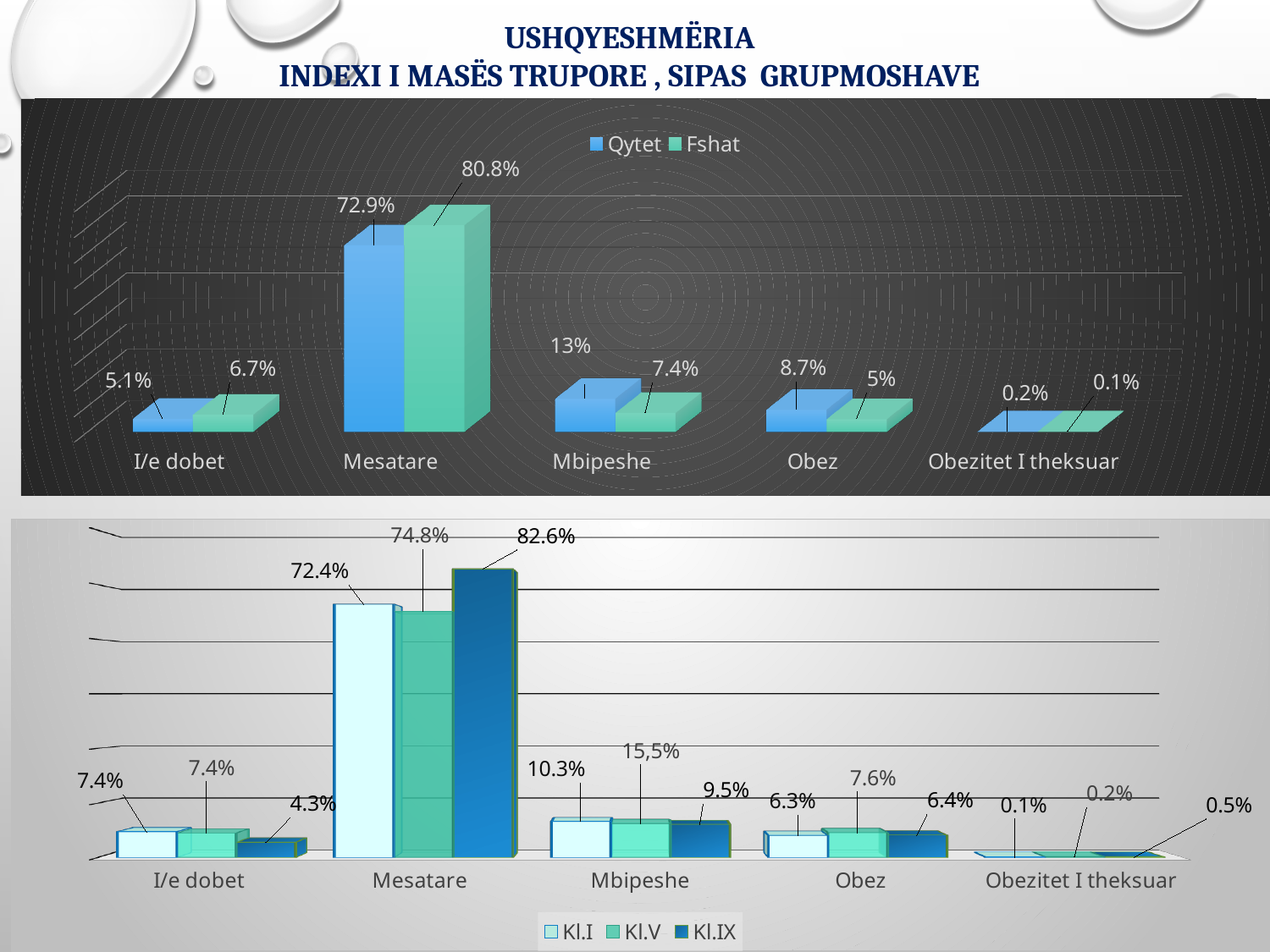
In the top chart, which category has the highest Fshat value? Mesatare In the top chart, what is the Qytet value for Mesatare? 72.9% In the top chart, what is the difference between the Fshat and Qytet values for Mesatare? 7.9% In the bottom chart, what is the Kl.IX value for Mesatare? 82.6% In the top chart, what is the Fshat value for Mbipeshe? 7.4% In the top chart, how many series does the legend list? 2 In the top chart, which category has the lowest Qytet value? Obezitet I theksuar In the bottom chart, what is the Kl.V value for Obez? 7.6% In the bottom chart, how many categories are shown on the x axis? 5 What kind of chart is the bottom chart? Bar chart In the top chart, which is larger for Obez: Qytet or Fshat? Qytet